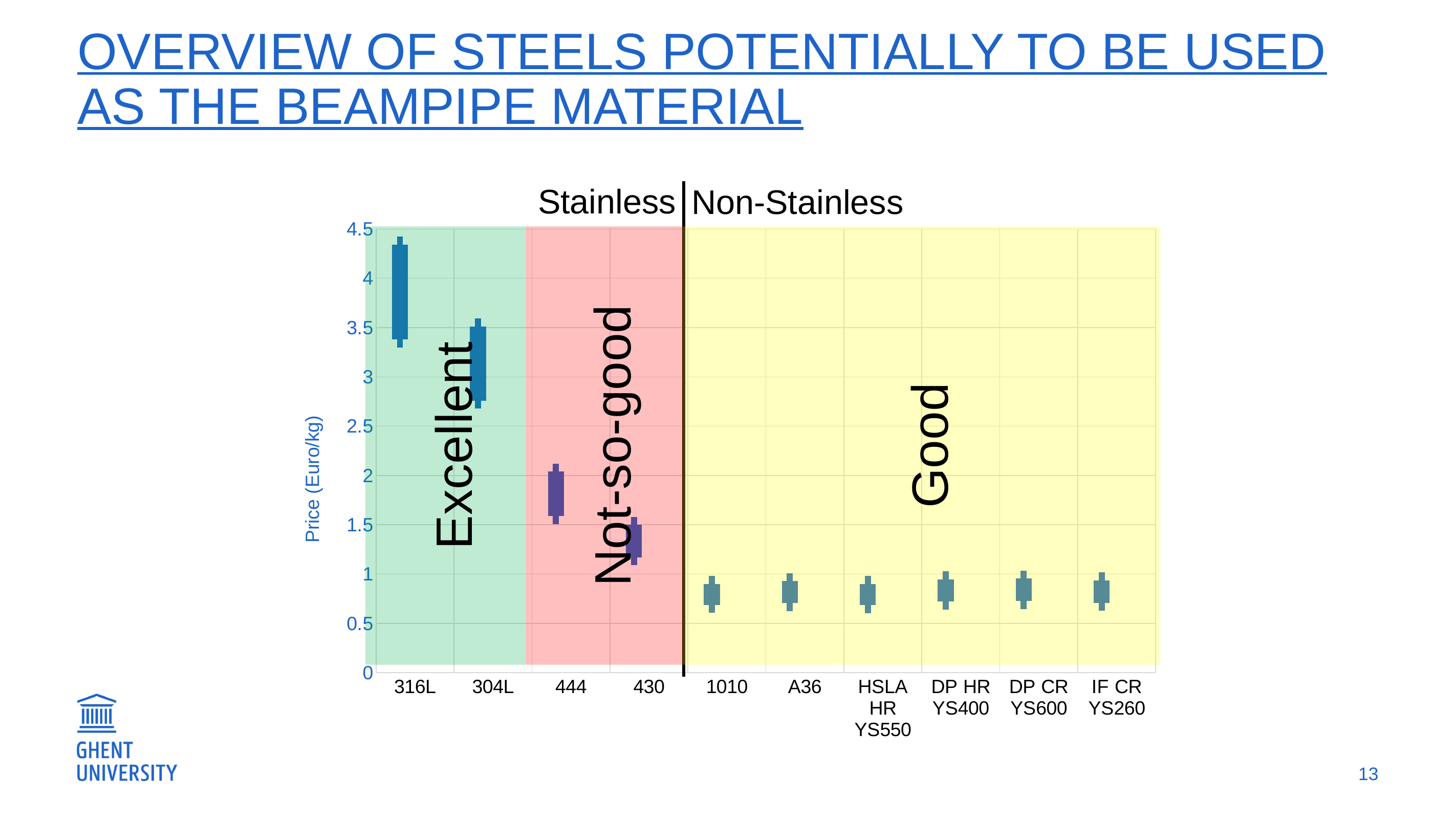
Is the price for 304L greater or less than 2.5 Euro/kg? greater What is the label of the y axis of the chart? Price (Euro/kg) Do the prices generally rise or fall moving from left to right along the x axis? fall How many steel categories are shown on the x axis of the chart? 10 Which has the higher price, 316L or 444? 316L Is the price for 316L greater or less than 3 Euro/kg? greater Which steel has the highest price range on the chart? 316L Is the price for 444 greater or less than 2.5 Euro/kg? less Which rating label is shown over the green region containing 316L and 304L? Excellent Which has the higher price, 444 or 430? 444